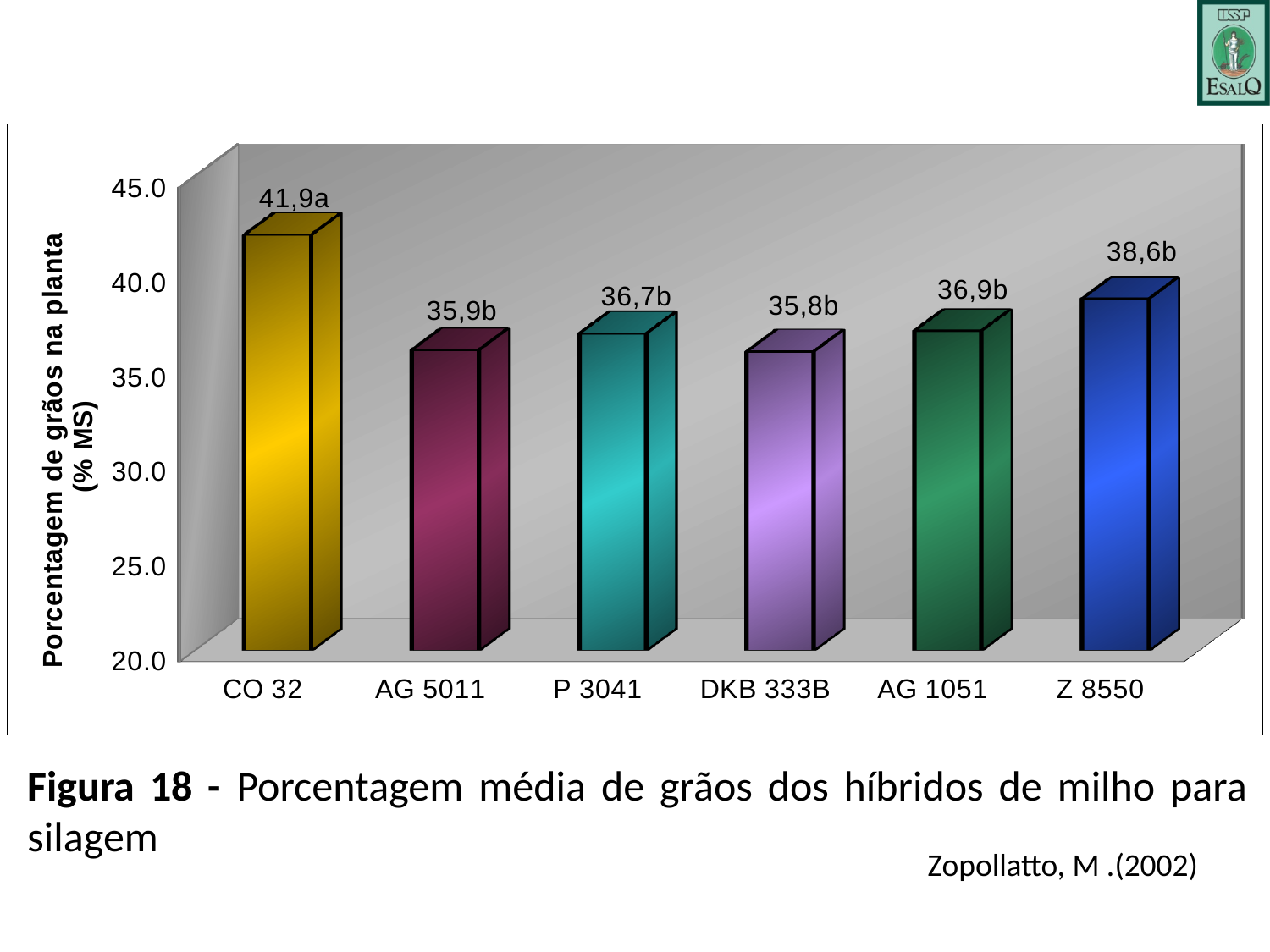
Which hybrid has the highest percentage of grains in the plant? CO 32 What is the value shown for CO 32? 41,9a Which hybrid has the lowest percentage of grains in the plant? DKB 333B What is the difference between the values for CO 32 and Z 8550? 3,3 What is the value shown for P 3041? 36,7b How many hybrids are shown on the x axis? 6 What is the value shown for AG 1051? 36,9b What is the label of the vertical axis? Porcentagem de grãos na planta (% MS) What kind of chart is shown on the slide? bar chart What is the value shown for Z 8550? 38,6b Is the value for Z 8550 greater or less than 40.0? less Which has a larger value, AG 1051 or AG 5011? AG 1051